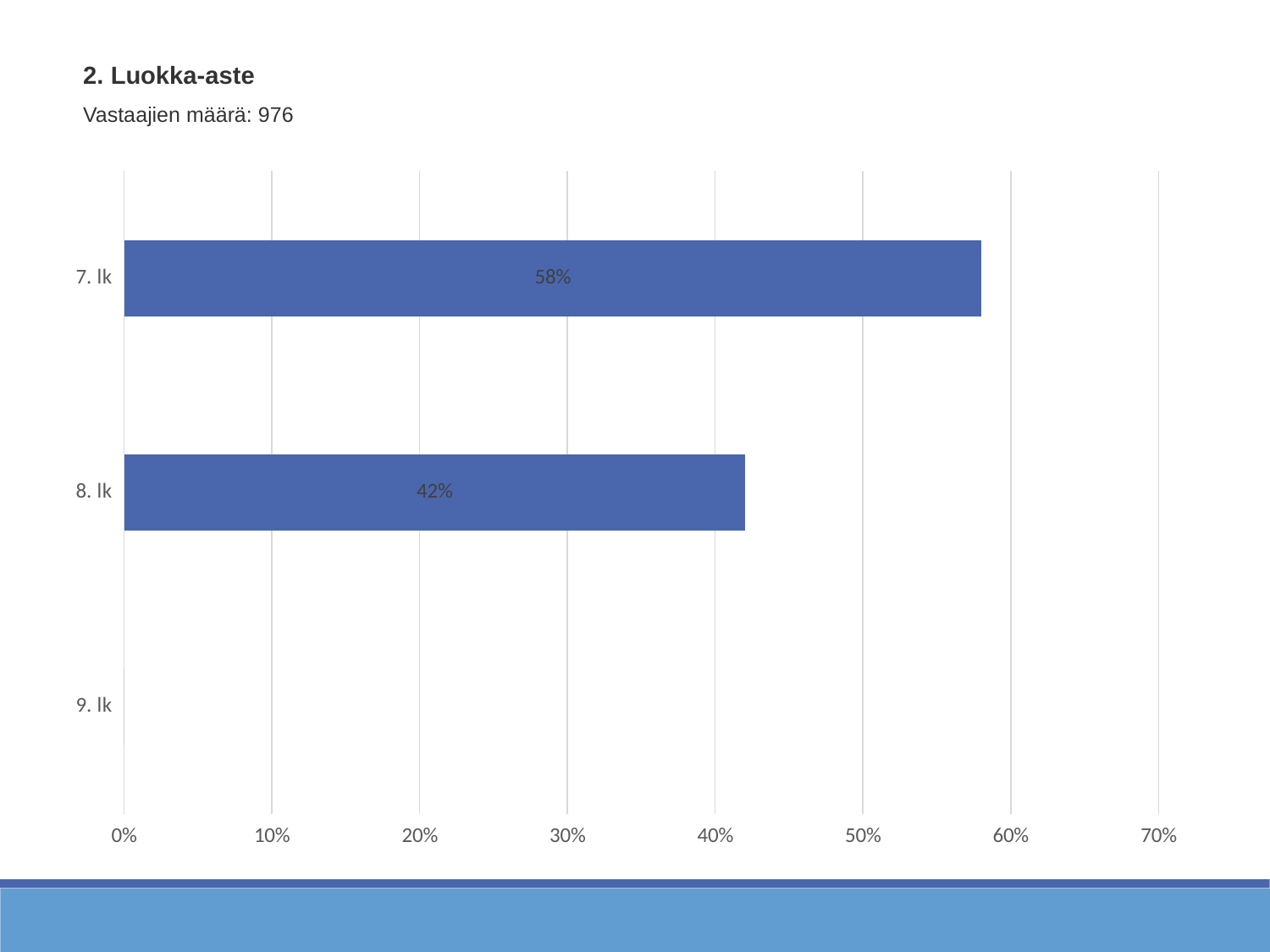
What is the value for 7. lk? 58% What is the title of the slide? 2. Luokka-aste Which is larger, the value for 7. lk or the value for 8. lk? 7. lk Which category has the lowest value? 9. lk How many categories are shown on the chart? 3 Is the value for 8. lk greater or less than 50%? less Is the value for 7. lk greater or less than 50%? greater What kind of chart is shown on the slide? Bar chart Which category has the highest value? 7. lk How many respondents (Vastaajien määrä) are stated on the slide? 976 What is the value for 8. lk? 42% What is the difference between the values for 7. lk and 8. lk? 16%